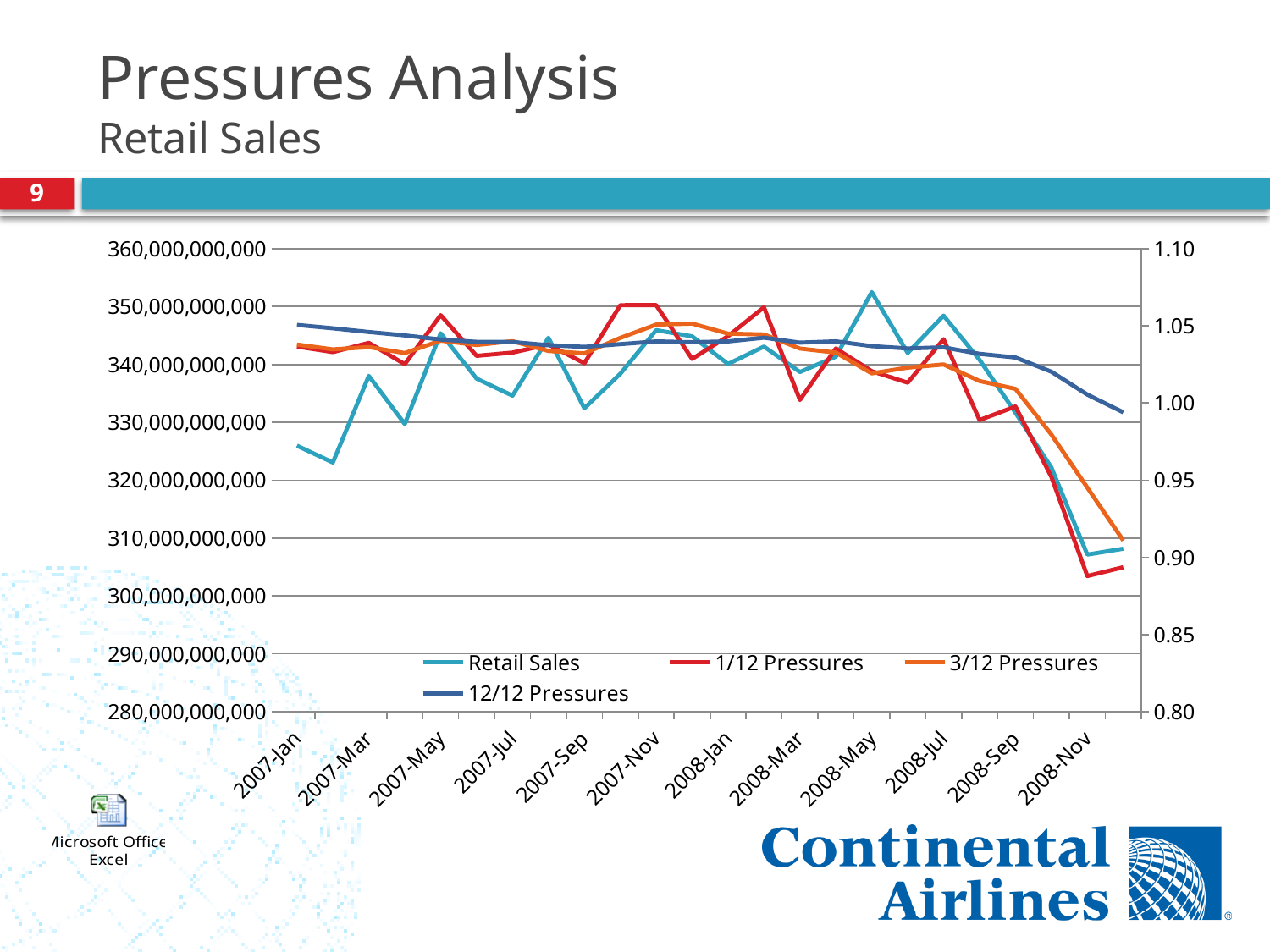
What kind of chart is shown on the slide? line chart Does the Retail Sales line rise or fall between 2008-Jul and 2008-Nov? fall Which is larger for Retail Sales: the value at 2007-Jan or the value at 2008-May? 2008-May How many series does the chart's legend list? 4 What colour is the 1/12 Pressures line in the chart? red Is the Retail Sales value for 2008-May greater or less than 350,000,000,000? greater Does the 12/12 Pressures line generally rise or fall from 2007-Jan to 2008-Nov? fall Is the Retail Sales value for 2007-Jan greater or less than 330,000,000,000? less At which month does the Retail Sales line reach its highest value? 2008-May Is the 1/12 Pressures value for 2008-Nov greater or less than 0.90? less Which series are listed in the chart's legend? Retail Sales, 1/12 Pressures, 3/12 Pressures, 12/12 Pressures